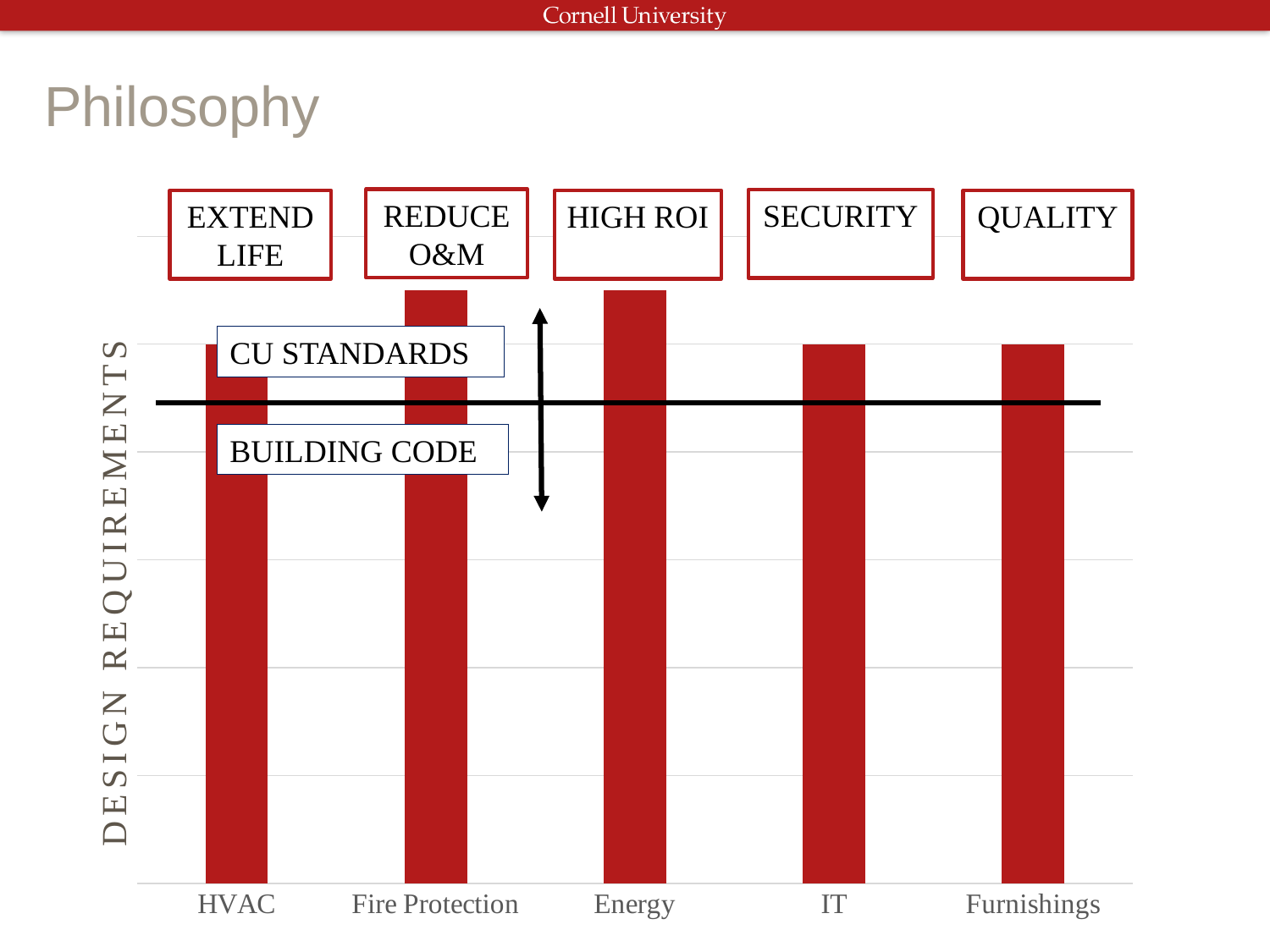
Which bar is taller, Energy or Furnishings? Energy What is the label on the vertical axis of the chart? DESIGN REQUIREMENTS Which bar is taller, Fire Protection or IT? Fire Protection Which bar is shorter, Energy or IT? IT What kind of chart is shown on the slide? Bar chart Which category is plotted last on the x axis of the chart? Furnishings How many categories are plotted on the x axis of the chart? 5 Which category is plotted first on the x axis of the chart? HVAC